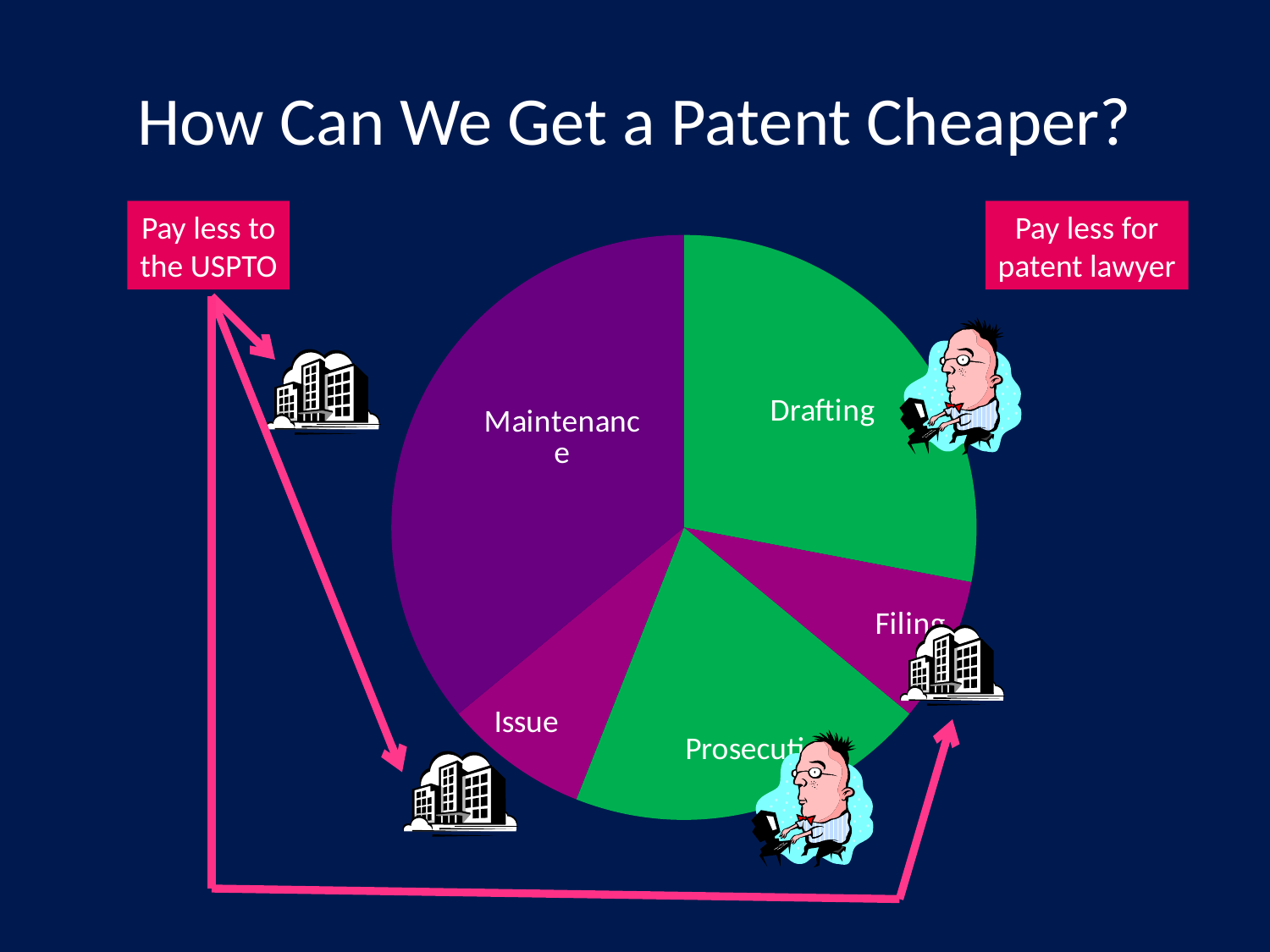
Which is larger in the pie chart, Maintenance or Issue? Maintenance Which is larger in the pie chart, Maintenance or Drafting? Maintenance Which is larger in the pie chart, Drafting or Prosecution? Drafting What kind of chart is shown on the slide? pie chart How many slices does the pie chart have? 5 Which slice of the pie chart is the largest? Maintenance What colour is the Maintenance slice of the pie chart? purple What is the title of the slide containing the pie chart? How Can We Get a Patent Cheaper?